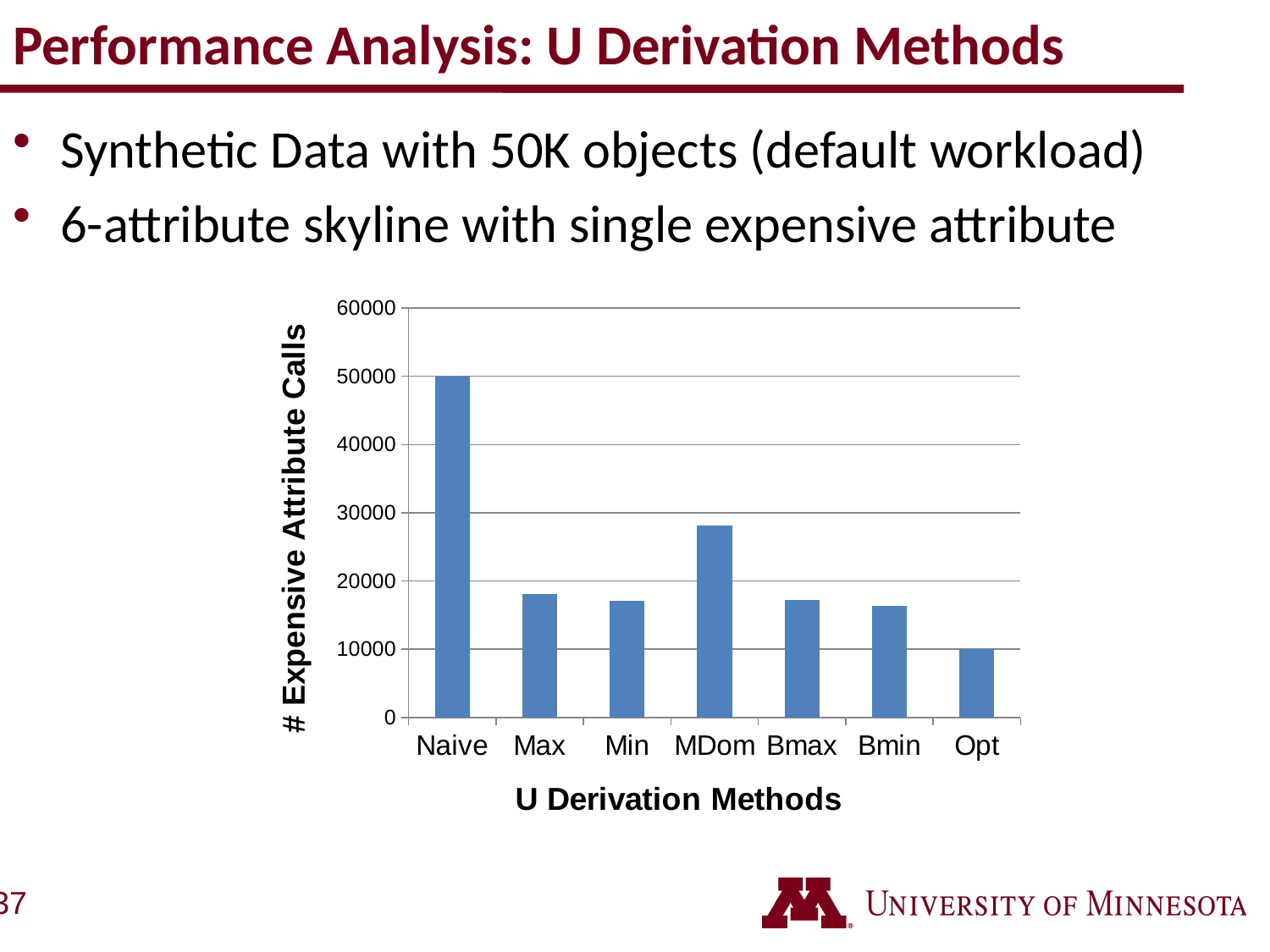
How many U derivation methods are plotted on the x axis? 7 What is the number of expensive attribute calls for Opt? 10000 What kind of chart is shown on the slide? bar chart Is the value for Bmin greater or less than 10000? greater What is the label of the x axis? U Derivation Methods Which U derivation method has the lowest number of expensive attribute calls? Opt Is the value for Max greater or less than 20000? less What is the number of expensive attribute calls for Naive? 50000 Is the value for MDom greater or less than 20000? greater What is the label of the y axis? # Expensive Attribute Calls Which has more expensive attribute calls, MDom or Max? MDom Which U derivation method has the highest number of expensive attribute calls? Naive